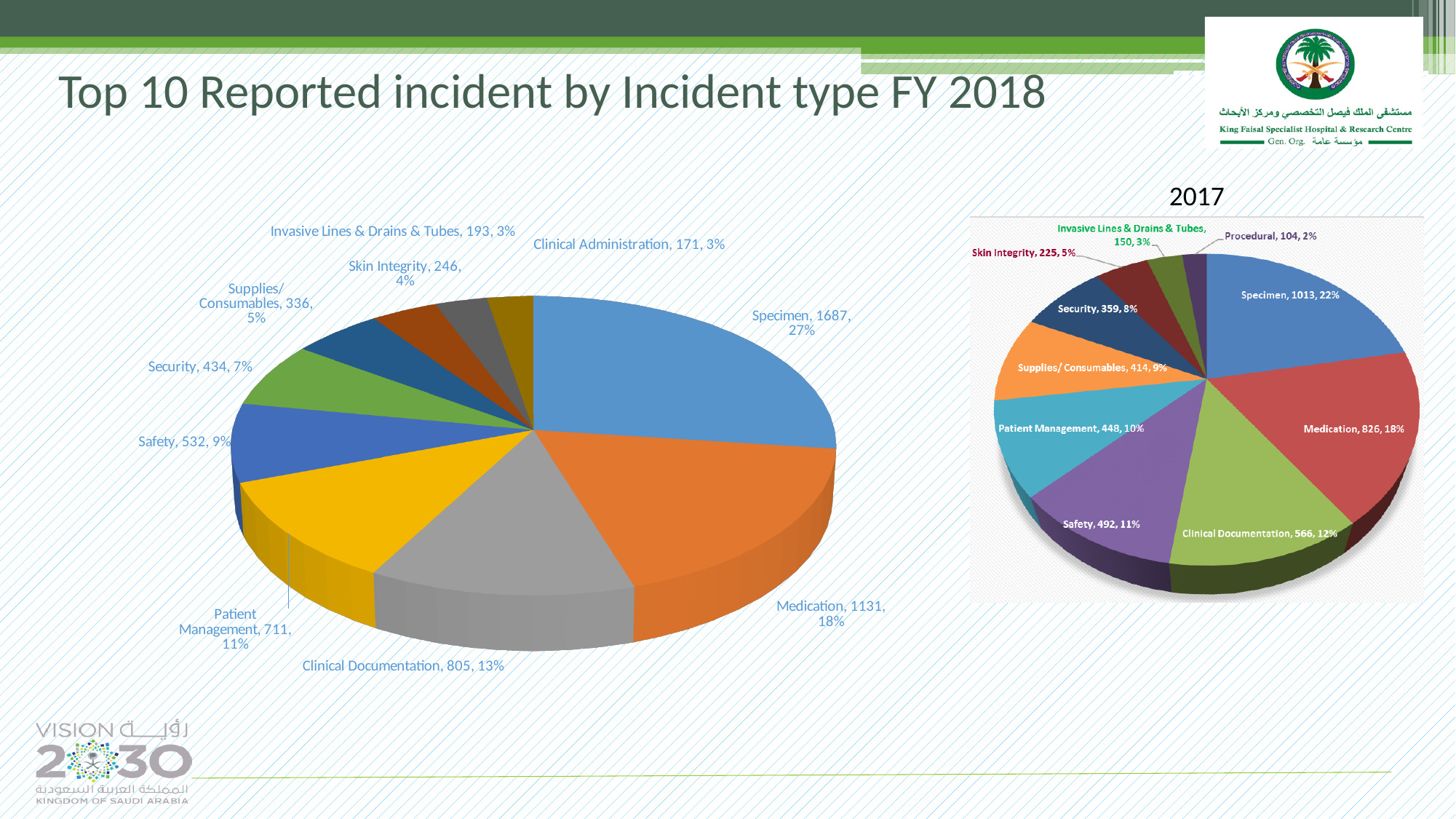
In the FY 2018 pie chart on the left, how many incidents were reported for Specimen? 1687 In the FY 2018 pie chart on the left, which incident type has the smallest count? Clinical Administration How many incident types are shown in the FY 2018 pie chart on the left? 10 In the FY 2018 pie chart on the left, what is the difference between the Medication and Clinical Documentation counts? 326 In the 2017 pie chart on the right, what is the difference between the Specimen and Medication counts? 187 In the FY 2018 pie chart on the left, which incident type has the largest slice? Specimen In the 2017 pie chart on the right, what share of incidents is Specimen? 22% In the FY 2018 pie chart on the left, which is larger, Safety or Security? Safety What type of chart is used for the FY 2018 data on the left? Pie chart In the FY 2018 pie chart on the left, what share of incidents is Medication? 18% In the 2017 pie chart on the right, which incident type has the smallest slice? Procedural In the 2017 pie chart on the right, how many incidents were reported for Patient Management? 448